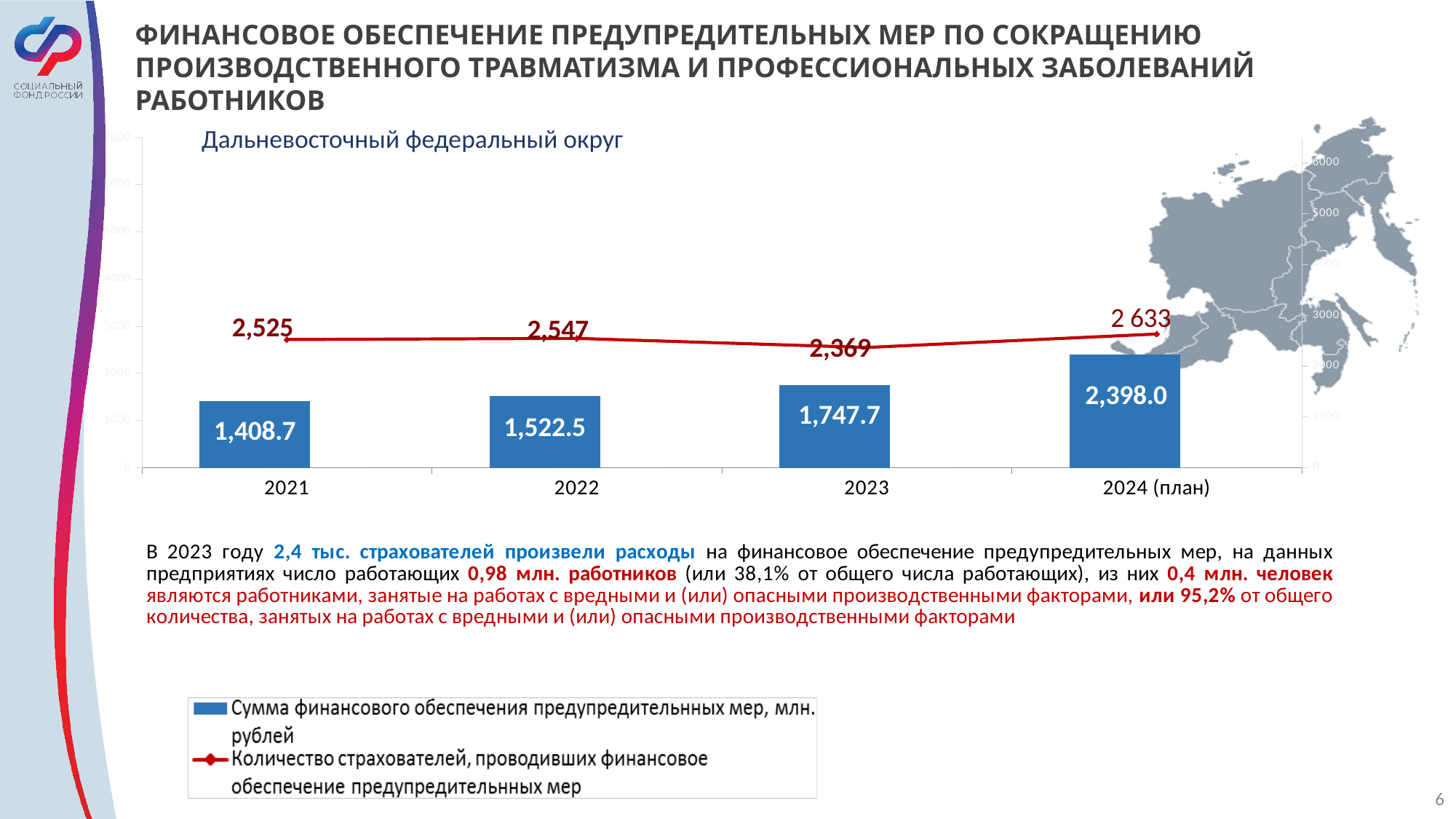
Which year has the lowest value on the red line (Количество страхователей)? 2023 What is the value of the bar for 2023 (Сумма финансового обеспечения предупредительных мер, млн. рублей)? 1,747.7 Do the bar values rise or fall from 2021 to 2024 (план)? Rise How many years (categories) are shown on the x axis? 4 What kind of chart is shown on the slide? Combined bar and line chart What is the difference between the bar values for 2024 (план) and 2023? 650.3 What is the value of the red line (Количество страхователей) for 2024 (план)? 2 633 What is the value of the red line (Количество страхователей) for 2022? 2,547 What is the value of the bar for 2021? 1,408.7 Which is larger: the bar value for 2022 or for 2021? 2022 How many series does the legend list? 2 Which year has the highest bar value for the financing amount? 2024 (план)